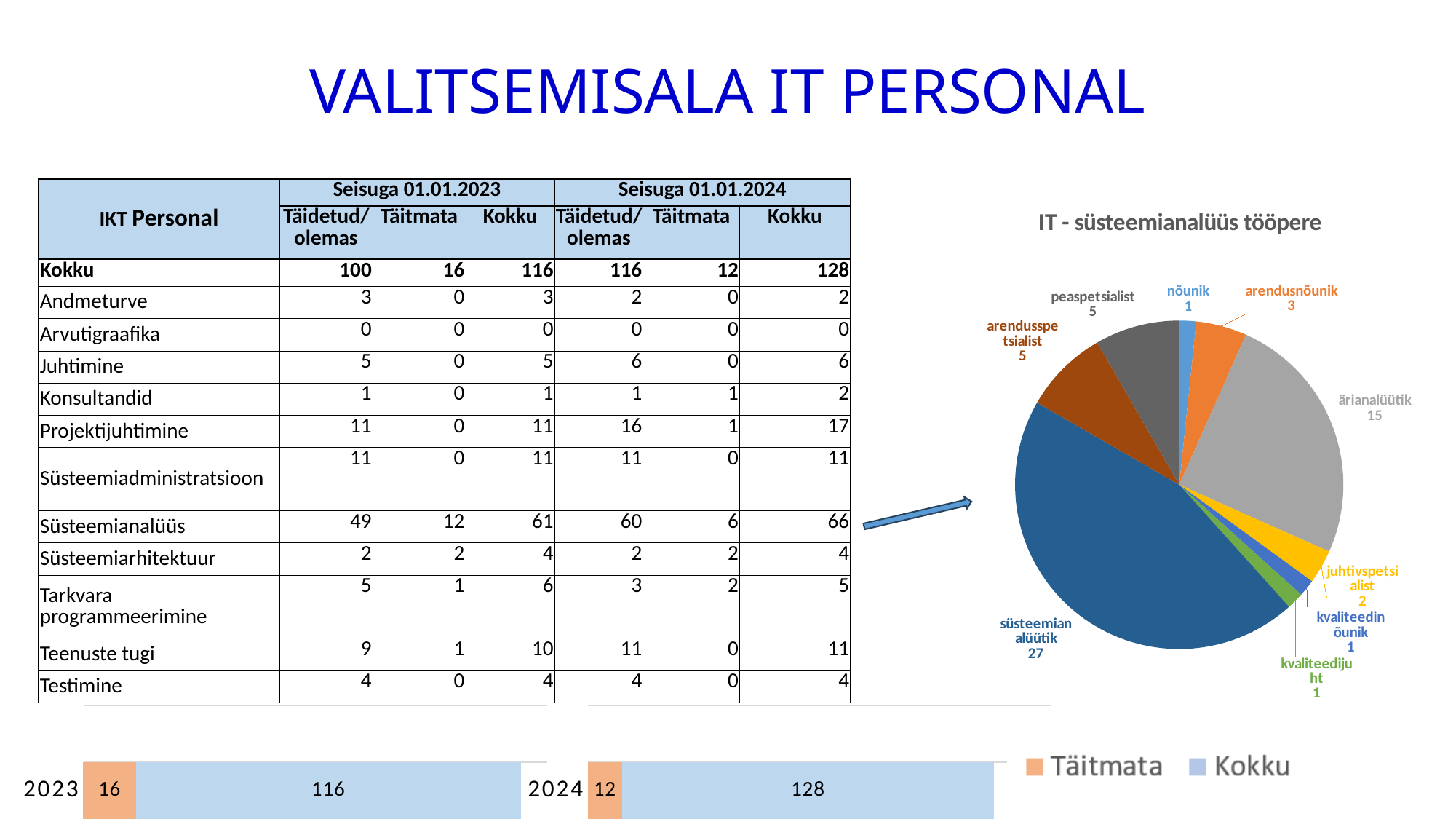
In the pie chart 'IT - süsteemianalüüs tööpere', which category has the largest slice? süsteemianalüütik In the pie chart 'IT - süsteemianalüüs tööpere', which is larger: peaspetsialist or juhtivspetsialist? peaspetsialist In the bar chart at the bottom of the slide, what is the Täitmata value for 2023? 16 In the pie chart 'IT - süsteemianalüüs tööpere', what is the difference between süsteemianalüütik and ärianalüütik? 12 What kind of chart is 'IT - süsteemianalüüs tööpere'? pie chart In the pie chart 'IT - süsteemianalüüs tööpere', what is the value for arendusnõunik? 3 In the pie chart 'IT - süsteemianalüüs tööpere', what share of the pie does süsteemianalüütik represent? 45% In the pie chart 'IT - süsteemianalüüs tööpere', how many slices does the pie have? 9 In the pie chart 'IT - süsteemianalüüs tööpere', what is the value for süsteemianalüütik? 27 In the bar chart at the bottom of the slide, what is the Kokku value for 2024? 128 How many series does the legend of the bar chart at the bottom of the slide list? 2 In the pie chart 'IT - süsteemianalüüs tööpere', what is the value for ärianalüütik? 15